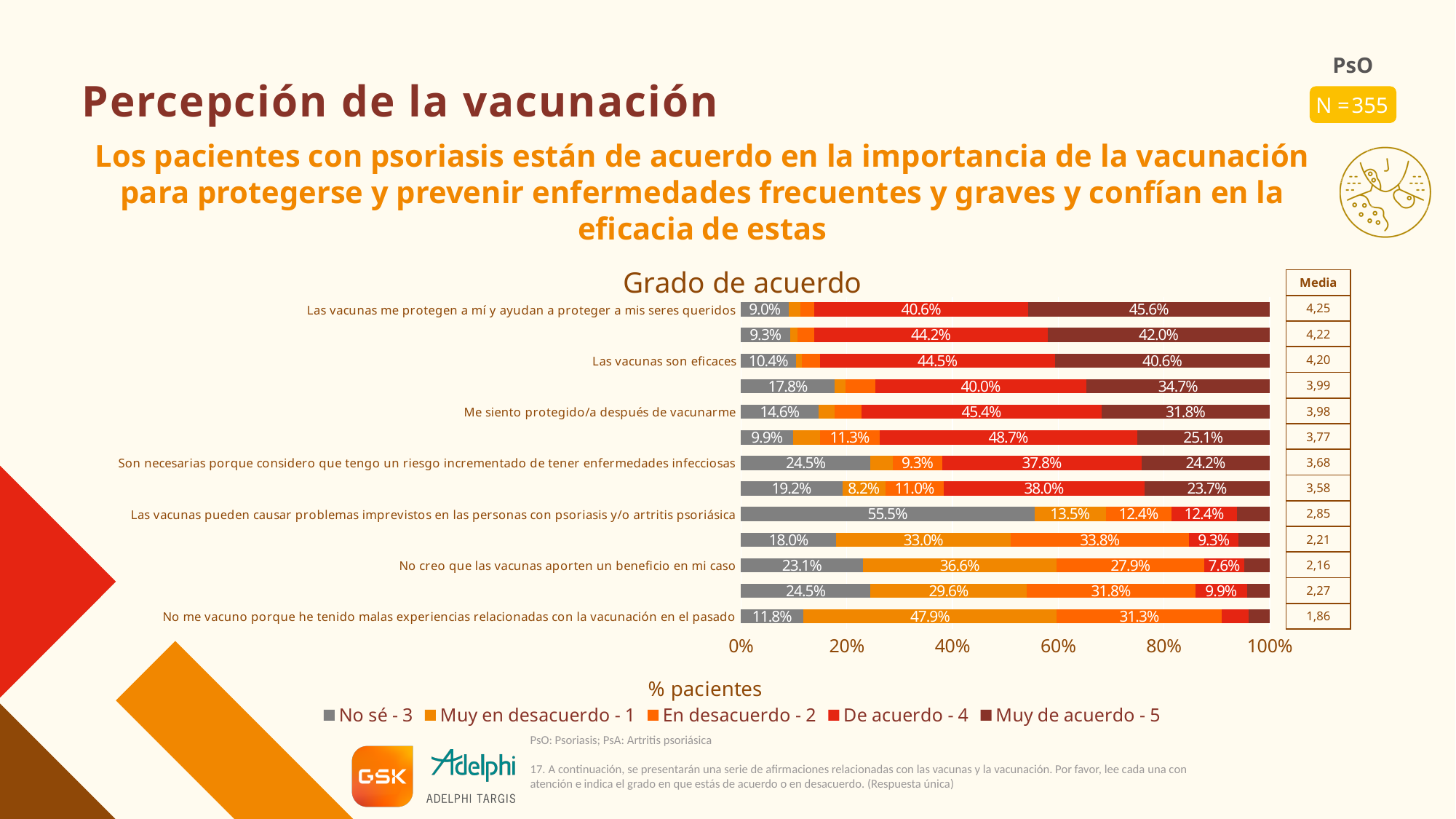
What percentage of patients answered "De acuerdo - 4" to "Las vacunas son eficaces"? 44.5% What percentage of patients answered "No sé - 3" to "Las vacunas pueden causar problemas imprevistos en las personas con psoriasis y/o artritis psoriásica"? 55.5% How many series does the legend of the "Grado de acuerdo" chart list? 5 What percentage of patients answered "Muy en desacuerdo - 1" to "No me vacuno porque he tenido malas experiencias relacionadas con la vacunación en el pasado"? 47.9% What is the difference between the "Muy de acuerdo - 5" share for "Las vacunas me protegen a mí y ayudan a proteger a mis seres queridos" and for "Las vacunas son eficaces"? 5.0% Which is larger: the "De acuerdo - 4" share for "Me siento protegido/a después de vacunarme" or for "Son necesarias porque considero que tengo un riesgo incrementado de tener enfermedades infecciosas"? Me siento protegido/a después de vacunarme Which statement has the highest "Muy de acuerdo - 5" percentage? Las vacunas me protegen a mí y ayudan a proteger a mis seres queridos How many bars (statements) are plotted in the "Grado de acuerdo" chart? 13 What percentage of patients answered "Muy de acuerdo - 5" to "Las vacunas me protegen a mí y ayudan a proteger a mis seres queridos"? 45.6% What is the x-axis label of the "Grado de acuerdo" chart? % pacientes What kind of chart is "Grado de acuerdo"? Stacked bar chart